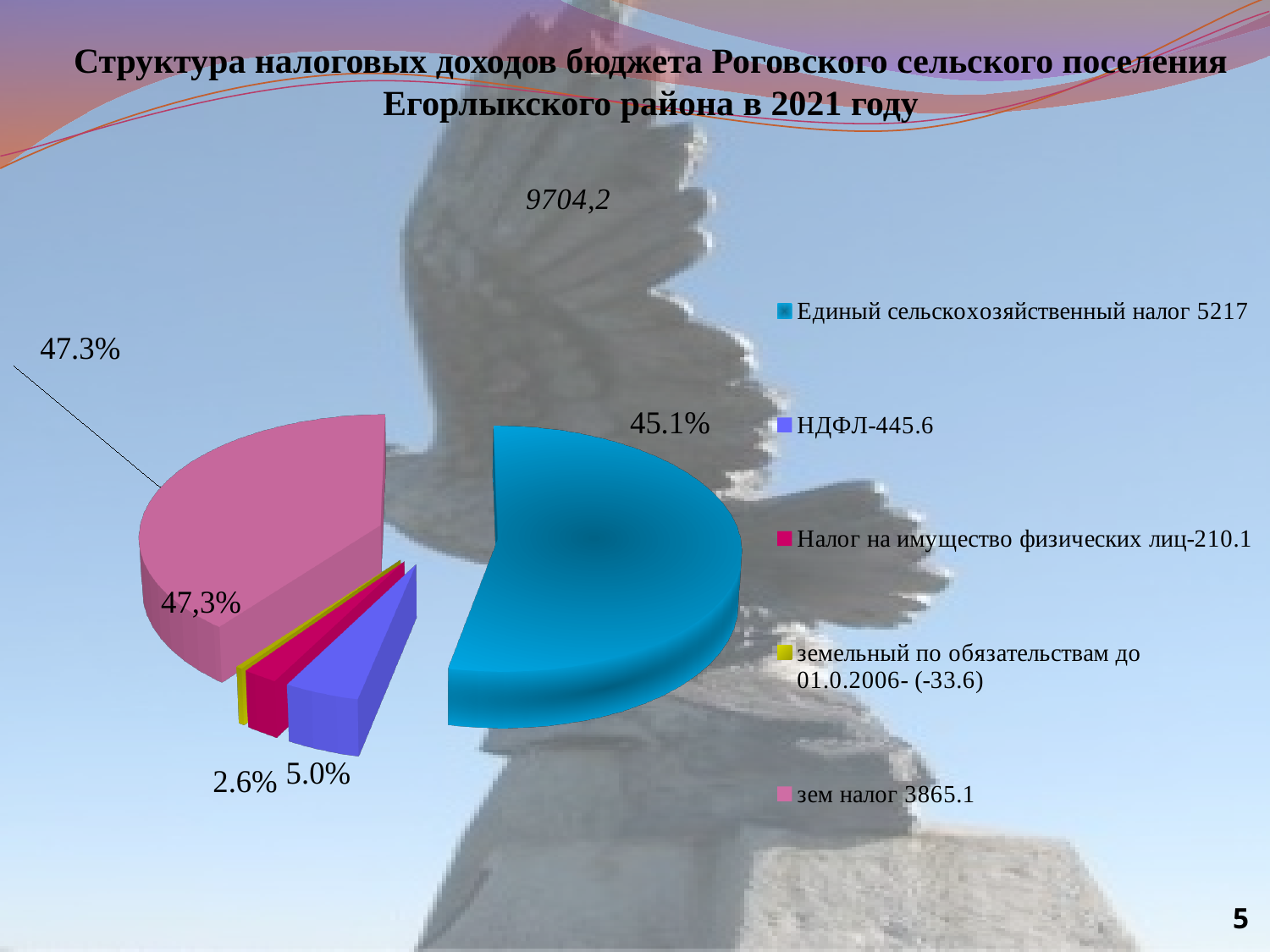
What is the difference in percentage points between the "зем налог" share (47.3%) and the "Единый сельскохозяйственный налог" share (45.1%)? 2.2 What value is given in the legend for "зем налог"? 3865.1 What share of the pie does "зем налог" have? 47.3% What share of the pie does "Налог на имущество физических лиц" have? 2.6% What value is given in the legend for "Единый сельскохозяйственный налог"? 5217 What share of the pie does "НДФЛ" have? 5.0% What colour is the slice for "Единый сельскохозяйственный налог"? blue What kind of chart is shown on the slide? pie chart How many entries does the legend of the pie chart list? 5